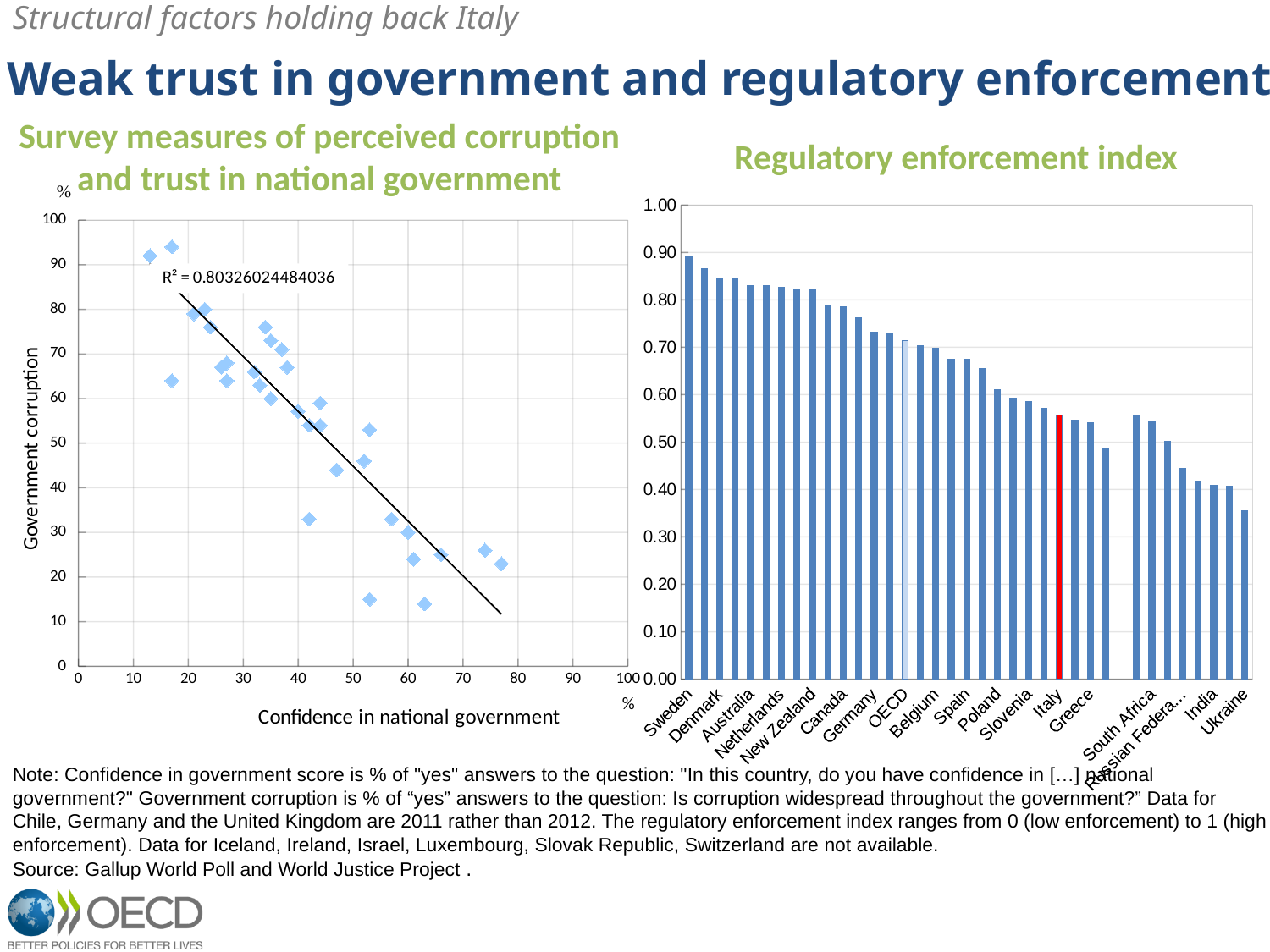
In the 'Regulatory enforcement index' chart, which country has the lowest value? Ukraine In the 'Regulatory enforcement index' chart, is the value for Sweden greater or less than 0.80? greater In the 'Regulatory enforcement index' chart, is the value for Italy greater or less than 0.60? less In the 'Regulatory enforcement index' chart, is the value for Germany greater or less than 0.70? greater In the 'Regulatory enforcement index' chart, do the bar values generally rise or fall from left to right? fall What kind of chart is the 'Survey measures of perceived corruption and trust in national government' chart on the left? scatter plot In the 'Regulatory enforcement index' chart, which country has the highest value? Sweden In the 'Regulatory enforcement index' chart, which has the larger value, Sweden or Italy? Sweden In the 'Regulatory enforcement index' chart, what colour is the bar for Italy? red In the 'Regulatory enforcement index' chart, which has the larger value, Germany or Greece? Germany What kind of chart is the 'Regulatory enforcement index' chart on the right? bar chart